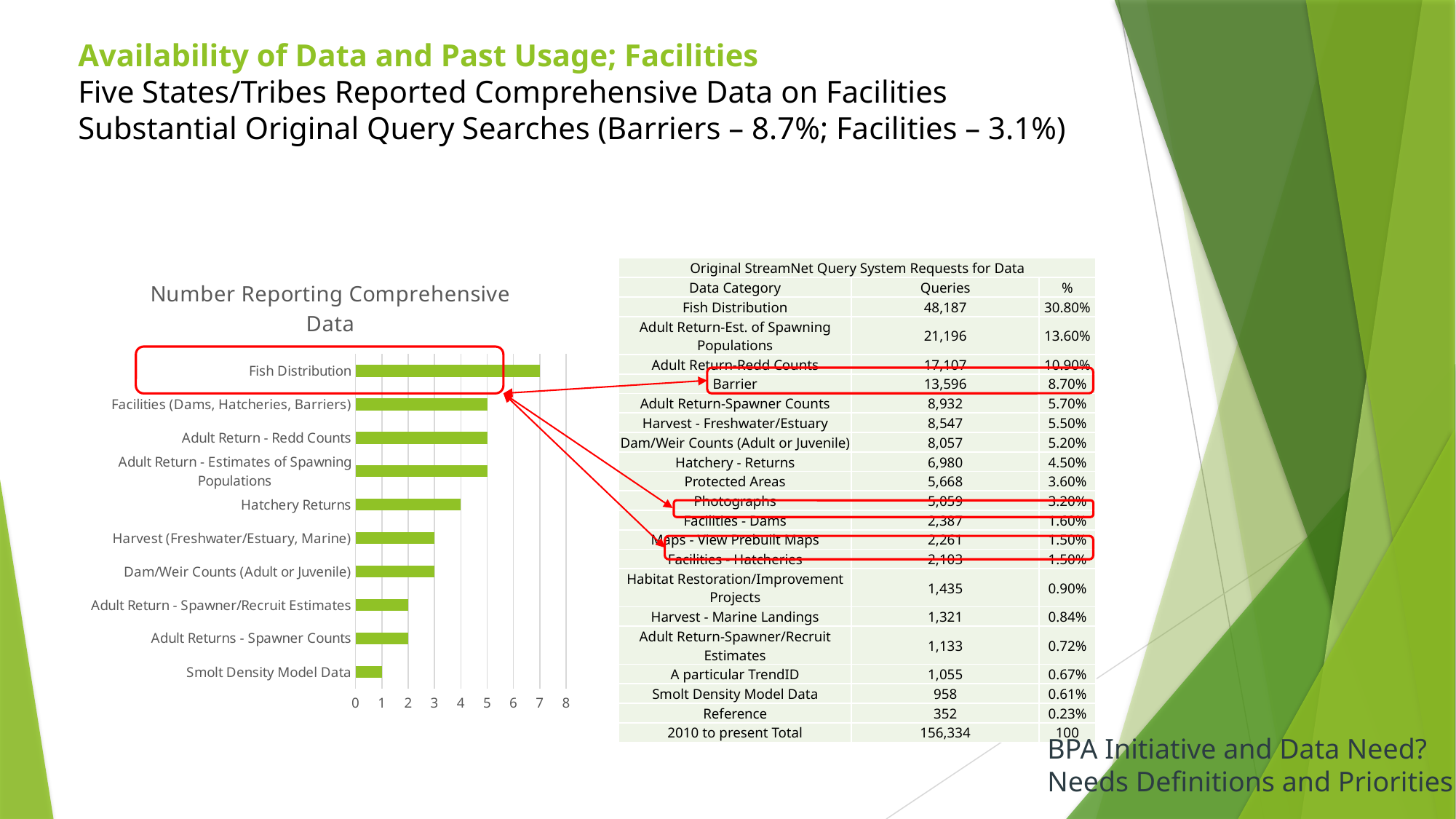
What is the value for Smolt Density Model Data? 1 What is the title of the chart? Number Reporting Comprehensive Data What is the difference between the values for Fish Distribution and Smolt Density Model Data? 6 Which category has the highest value in the chart? Fish Distribution Which is larger, the value for Hatchery Returns or the value for Harvest (Freshwater/Estuary, Marine)? Hatchery Returns What is the value for Fish Distribution? 7 What kind of chart is shown on the slide? bar chart What is the value for Facilities (Dams, Hatcheries, Barriers)? 5 What is the value for Hatchery Returns? 4 How many categories are plotted in the chart? 10 Is the value for Fish Distribution greater or less than 6? greater Which category has the lowest value in the chart? Smolt Density Model Data